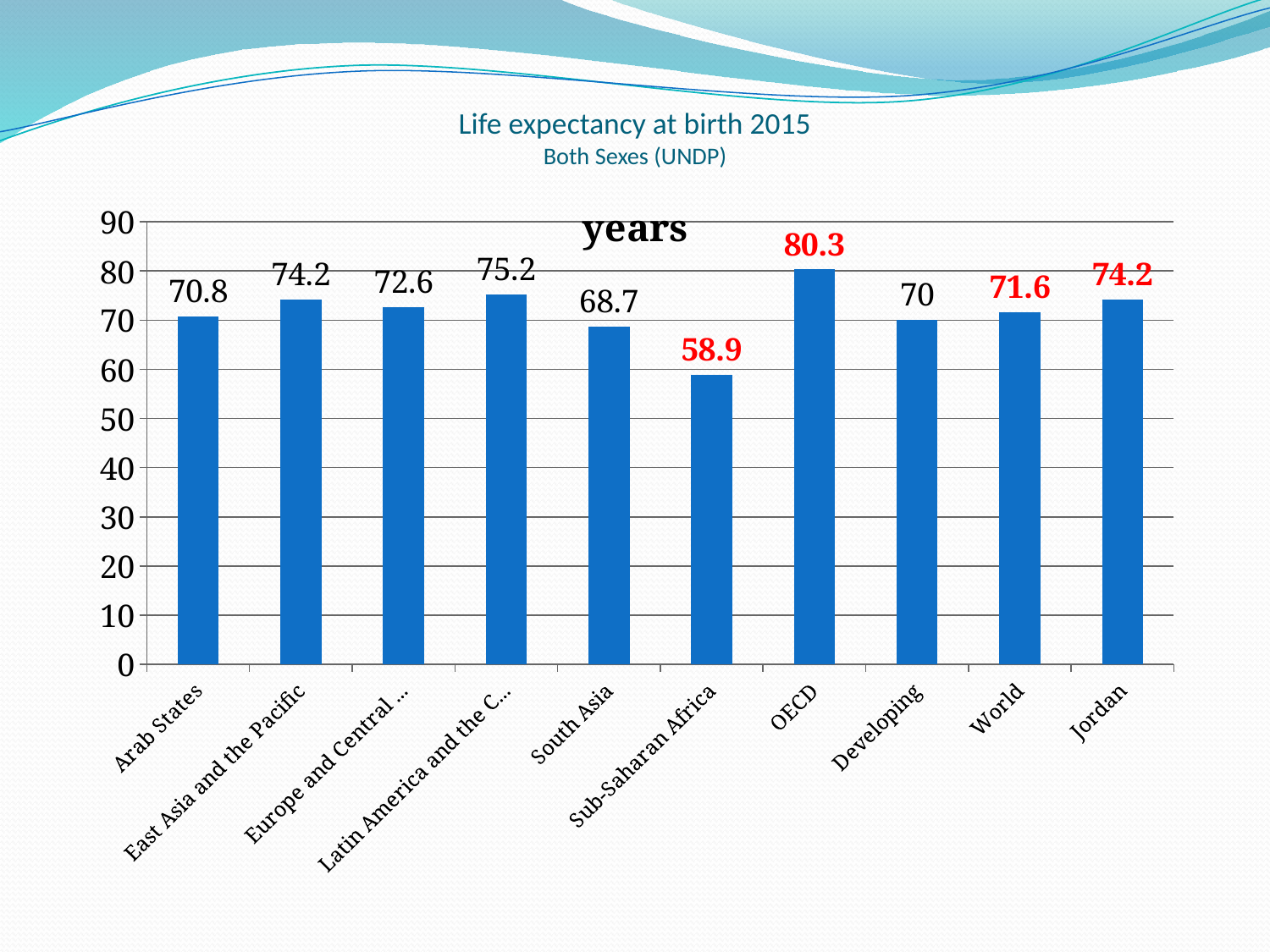
What is the value shown for the World? 71.6 Which category has the highest life expectancy? OECD What is the value shown for South Asia? 68.7 What is the difference between the OECD value and the Sub-Saharan Africa value? 21.4 How many categories are shown on the x axis? 10 Is the value for South Asia greater or less than 70? less Which category has the lowest life expectancy? Sub-Saharan Africa What kind of chart is shown on the slide? bar chart What is the value shown for Developing? 70 What is the value shown for Sub-Saharan Africa? 58.9 What is the life expectancy value shown for Jordan? 74.2 Which is larger, the value for Jordan or the value for the World? Jordan